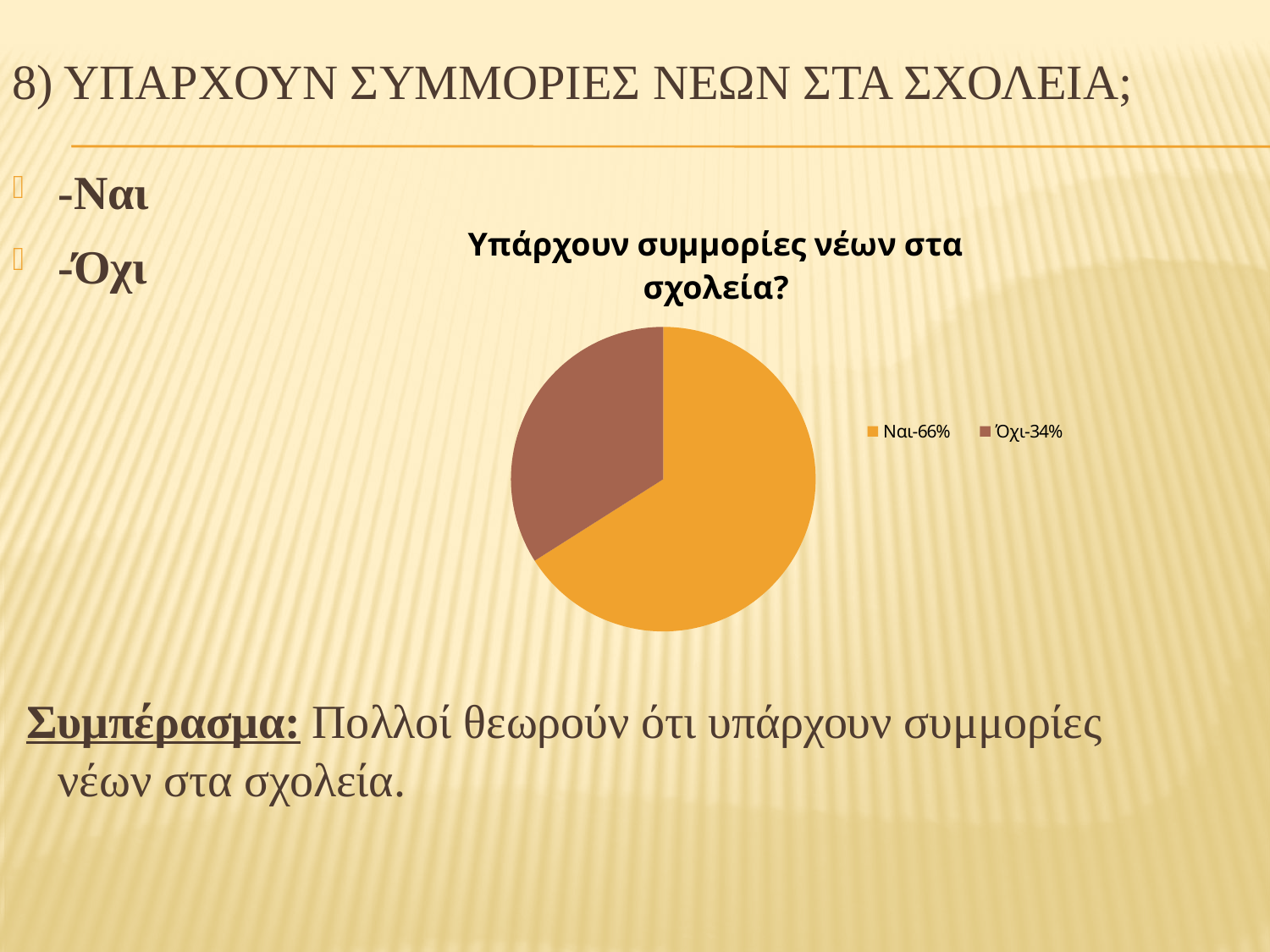
How many slices does the pie chart have? 2 What colour is the slice for Ναι? orange Which answer has the largest share of the pie? Ναι How many entries does the legend list? 2 What percentage does the legend give for Ναι? 66% What is the difference in percentage points between Ναι and Όχι? 32 What percentage does the legend give for Όχι? 34% Which is larger, the share for Ναι or the share for Όχι? Ναι What kind of chart is shown on the slide? pie chart What is the title of the chart? Υπάρχουν συμμορίες νέων στα σχολεία? Which answer has the smallest share of the pie? Όχι